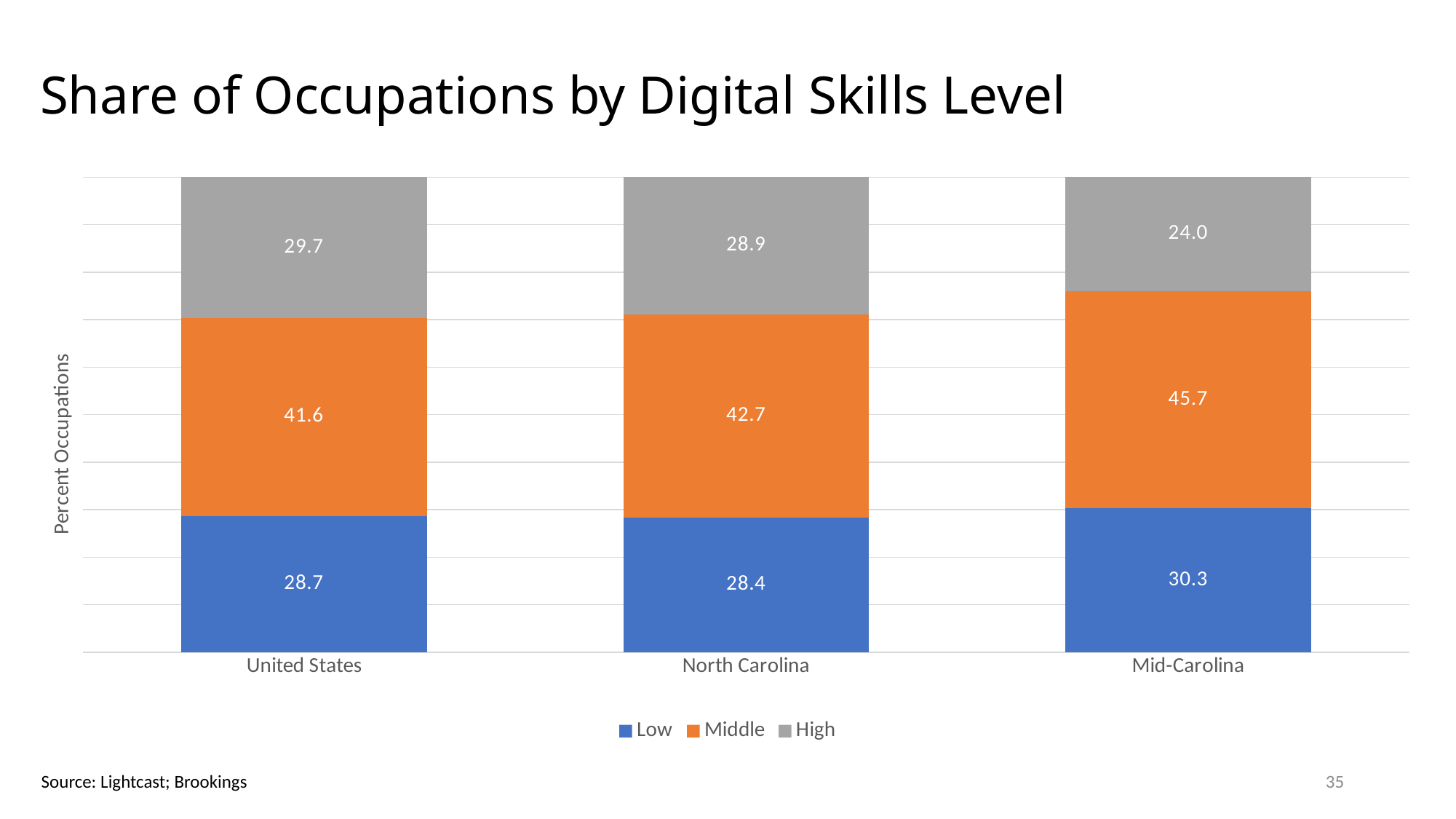
What is the High value for United States? 29.7 What kind of chart is shown on the slide? Stacked bar chart Which category has the lowest High value? Mid-Carolina How many series does the legend list? 3 Which is larger, the High value for United States or the High value for Mid-Carolina? United States What is the total of the stacked bar for North Carolina? 100.0 How many categories are shown on the x axis? 3 Which category has the highest Middle value? Mid-Carolina What is the title of the chart? Share of Occupations by Digital Skills Level What is the Low value for North Carolina? 28.4 What is the difference between the Middle values for Mid-Carolina and United States? 4.1 What is the Middle value for Mid-Carolina? 45.7